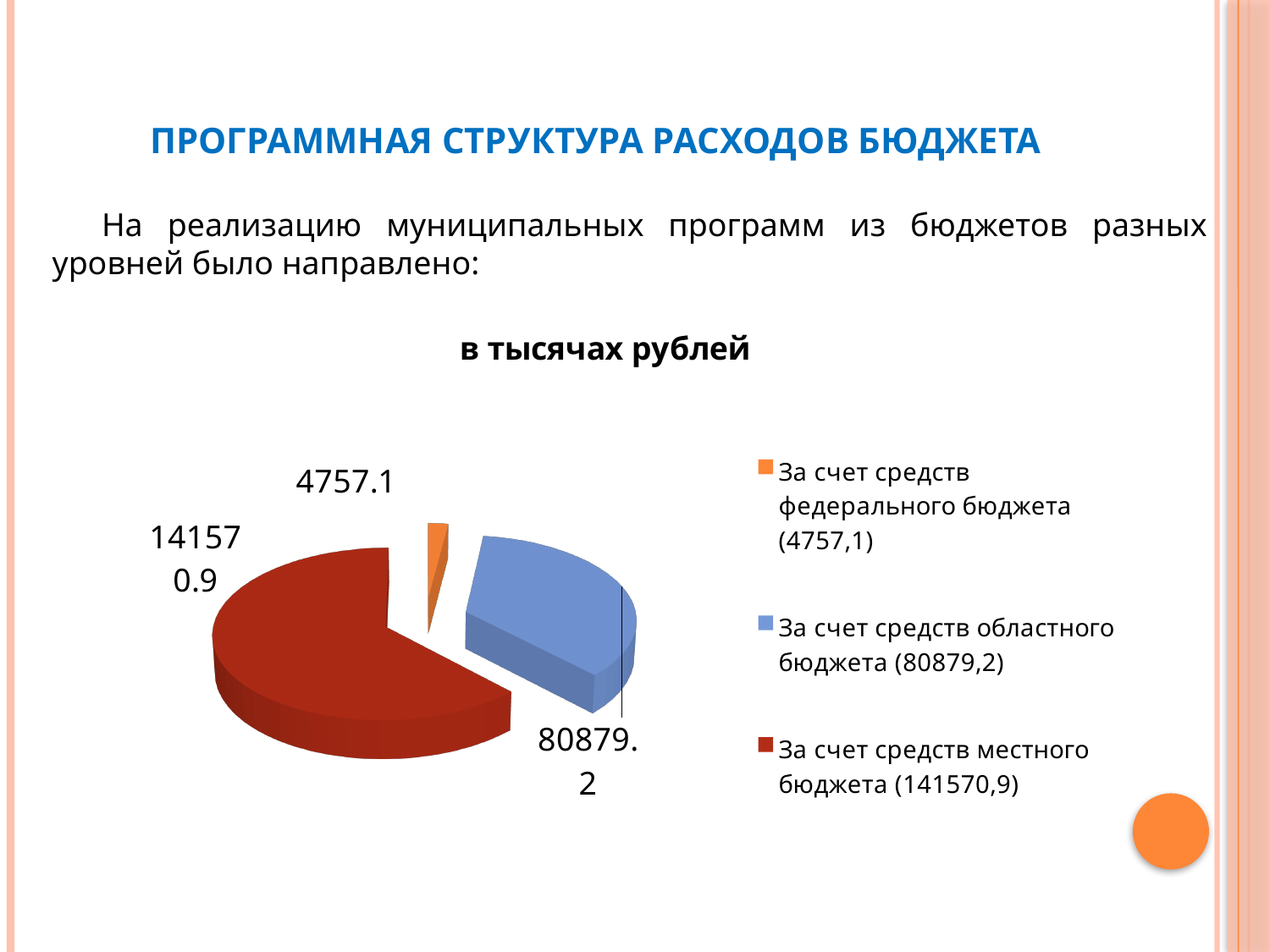
What is the title of the pie chart? в тысячах рублей Which is larger in the pie chart: the regional budget value or the federal budget value? За счет средств областного бюджета Which budget source has the largest slice in the pie chart? За счет средств местного бюджета What is the value for 'За счет средств областного бюджета' in the pie chart? 80879.2 What colour is the slice for 'За счет средств федерального бюджета' in the pie chart? orange How many slices does the pie chart have? 3 What is the value for 'За счет средств федерального бюджета' in the pie chart? 4757.1 What is the difference between the local budget value (141570.9) and the regional budget value (80879.2) in the pie chart? 60691.7 What is the value for 'За счет средств местного бюджета' in the pie chart? 141570.9 Which budget source has the smallest slice in the pie chart? За счет средств федерального бюджета What kind of chart is shown on the slide? pie chart How many entries does the legend of the pie chart list? 3